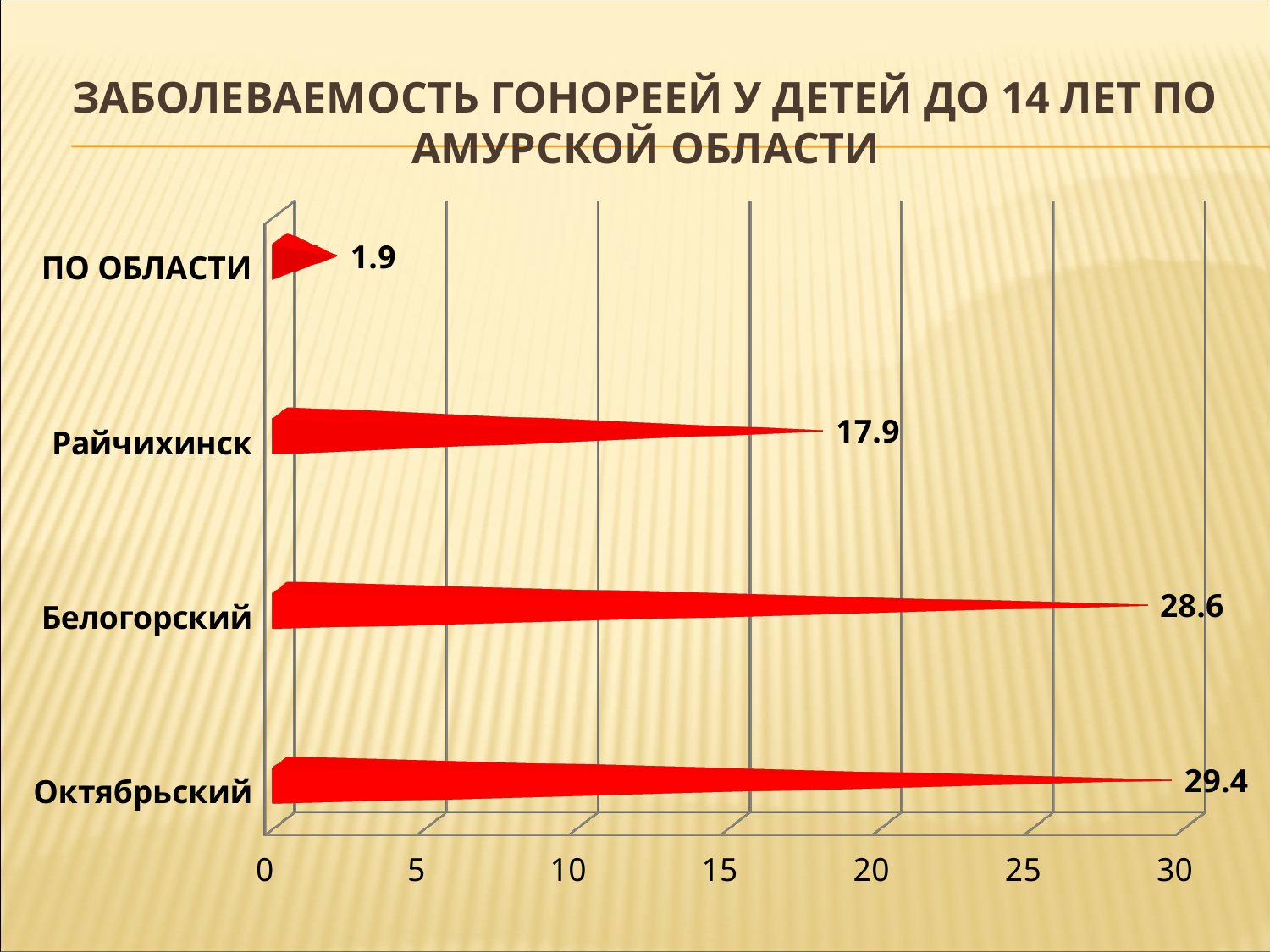
How many categories are shown in the chart? 4 What is the value for Райчихинск? 17.9 What is the value for ПО ОБЛАСТИ? 1.9 What is the value for Белогорский? 28.6 What is the value for Октябрьский? 29.4 Which is larger, the value for Райчихинск or the value for Белогорский? Белогорский What is the difference between the values for Октябрьский and ПО ОБЛАСТИ? 27.5 Which category has the highest value? Октябрьский Which category has the lowest value? ПО ОБЛАСТИ Is the value for Райчихинск greater or less than 20? less What is the difference between the values for Белогорский and Райчихинск? 10.7 What kind of chart is shown on the slide? bar chart